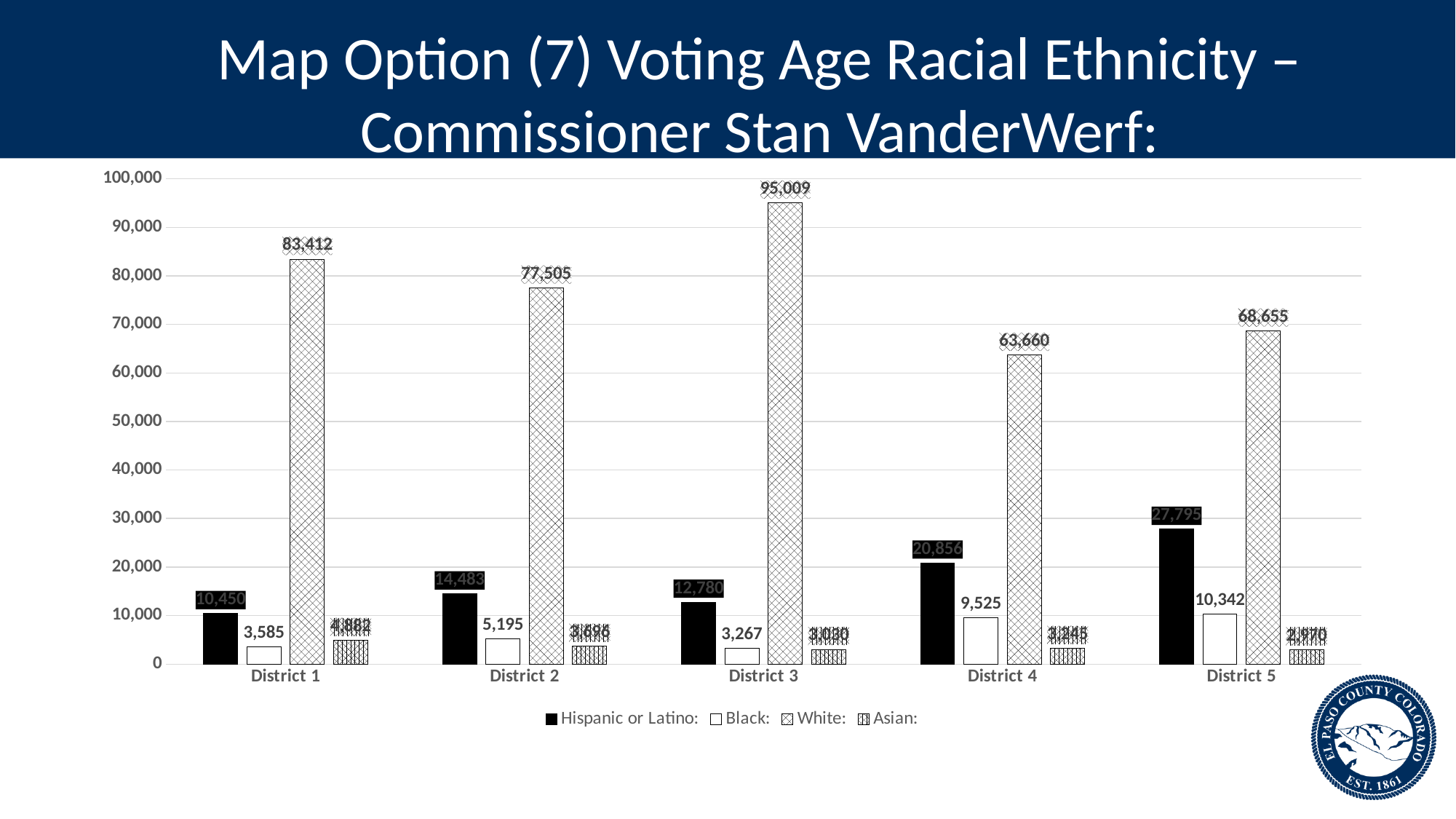
How many districts are shown on the x axis? 5 Which is larger, the Hispanic or Latino value for District 2 or for District 3? District 2 What is the value for Black in District 5? 10,342 What is the value for Hispanic or Latino in District 1? 10,450 How many series does the legend list? 4 What is the difference between the White values for District 1 and District 2? 5,907 What is the value for White in District 3? 95,009 What kind of chart is shown on the slide? Bar chart Which district has the highest White value? District 3 Which district has the lowest Black value? District 3 Is the White value for District 4 greater or less than 60,000? greater What is the value for Hispanic or Latino in District 4? 20,856